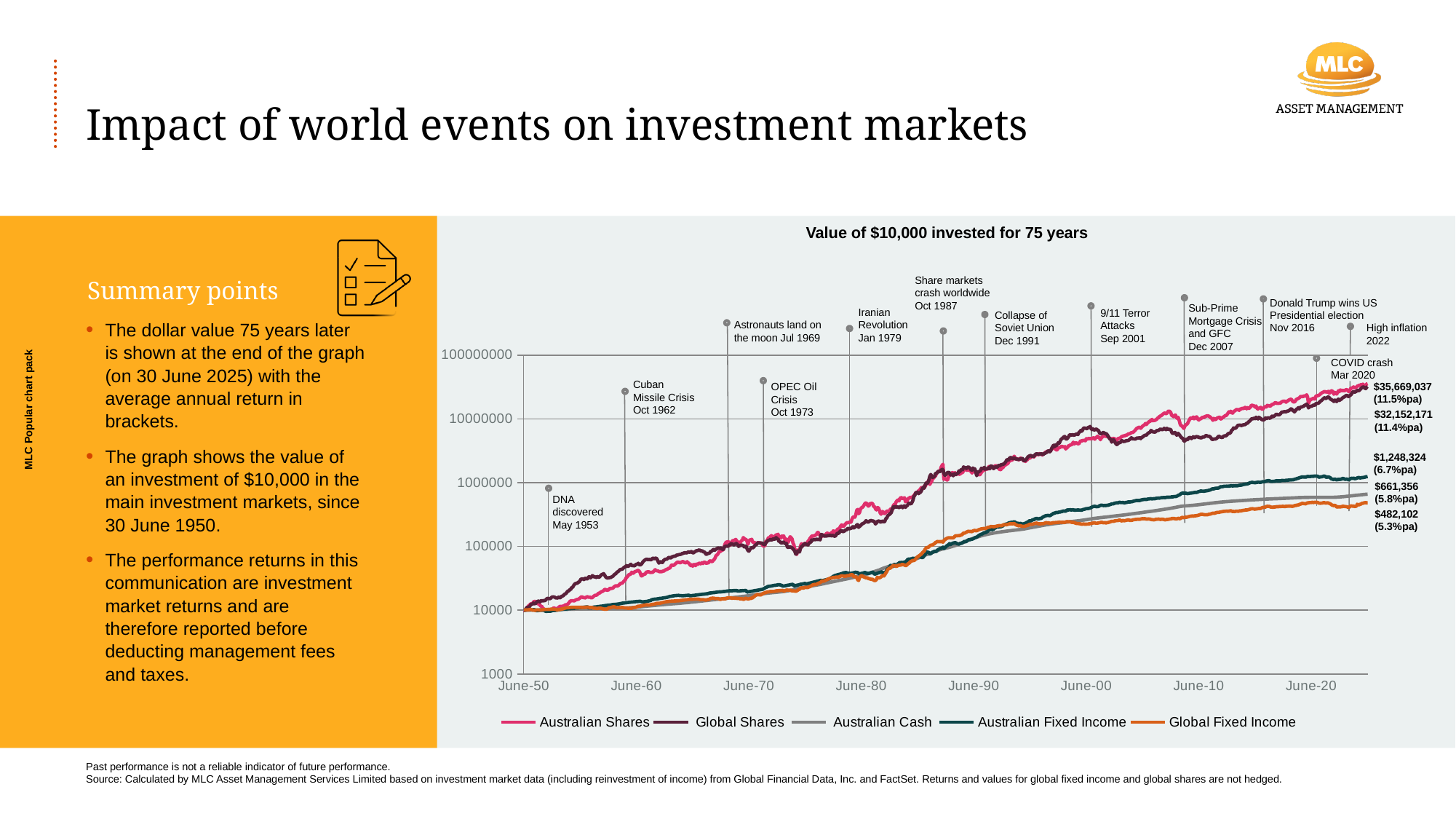
What is the end value shown for Global Shares? $32,152,171 Which series has the highest end value? Australian Shares What is the end value shown for Global Fixed Income? $482,102 What is the title of the chart? Value of $10,000 invested for 75 years Is the value for Australian Cash at June-00 greater or less than 1000000? less What kind of chart is shown on the slide? Line chart Which has a higher end value, Australian Cash or Australian Fixed Income? Australian Fixed Income What is the end value shown for Australian Shares? $35,669,037 What average annual return is shown in brackets for Australian Fixed Income? 6.7%pa What is the difference between the end values of Australian Shares and Global Shares? $3,516,866 How many series does the chart legend list? 5 Which series has the lowest end value? Global Fixed Income